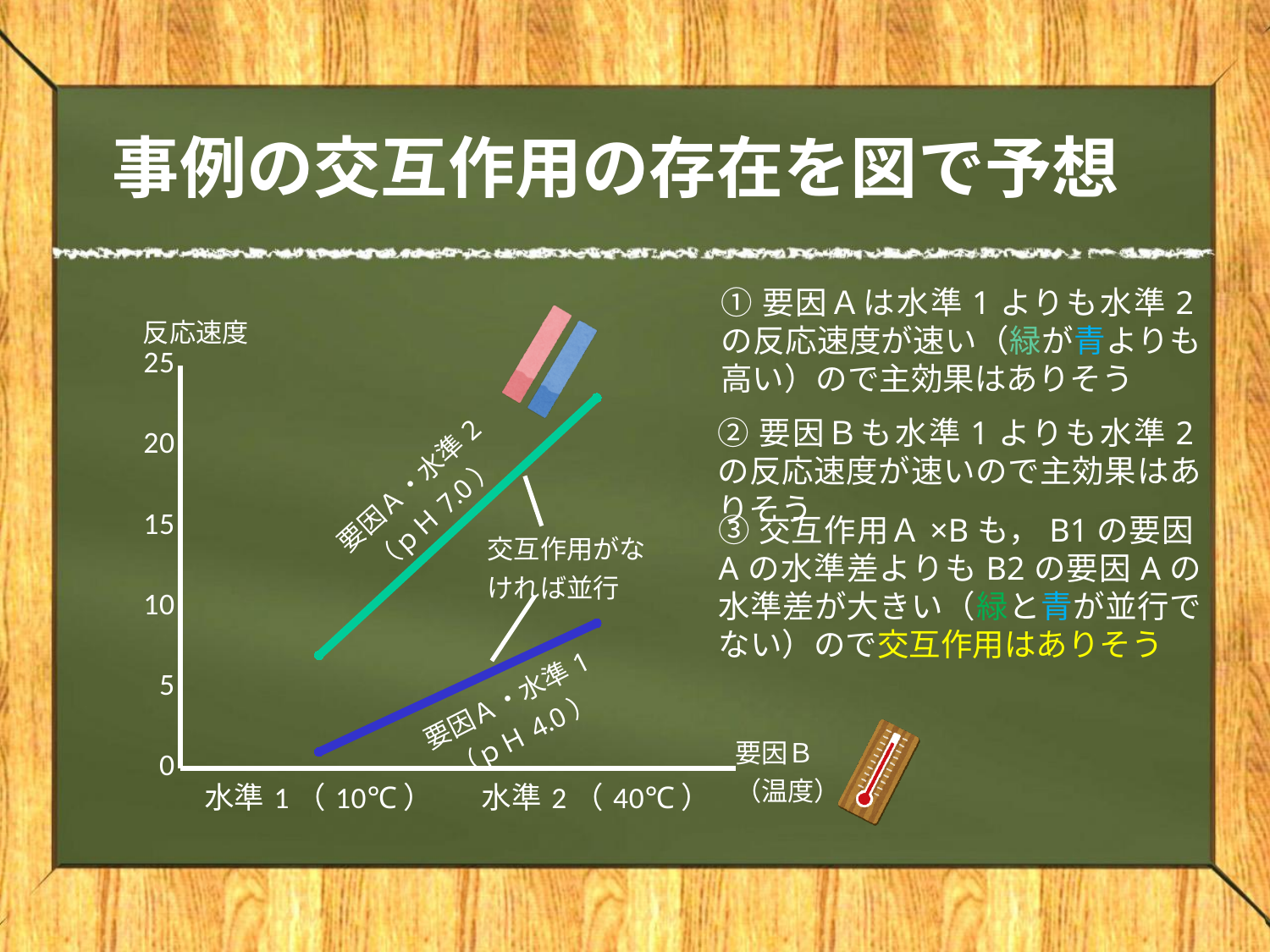
Does the 要因A・水準2 (pH 7.0) line rise or fall from 水準1 (10℃) to 水準2 (40℃)? rise Is the 反応速度 of the 要因A・水準2 (pH 7.0) line at 水準1 (10℃) greater or less than 10? less How many lines are plotted in the chart? 2 What kind of chart is shown on the slide? line chart Does the 要因A・水準1 (pH 4.0) line rise or fall from 水準1 (10℃) to 水準2 (40℃)? rise Is the 反応速度 of the 要因A・水準1 (pH 4.0) line at 水準2 (40℃) greater or less than 15? less How many levels of 要因B are shown on the x axis? 2 Is the 反応速度 of the 要因A・水準2 (pH 7.0) line at 水準2 (40℃) greater or less than 20? greater At 水準2 (40℃), which line has the higher 反応速度: 要因A・水準2 (pH 7.0) or 要因A・水準1 (pH 4.0)? 要因A・水準2 (pH 7.0) Which line has the higher 反応速度 at 水準1 (10℃)? 要因A・水準2 (pH 7.0) What is the label of the vertical axis of the chart? 反応速度